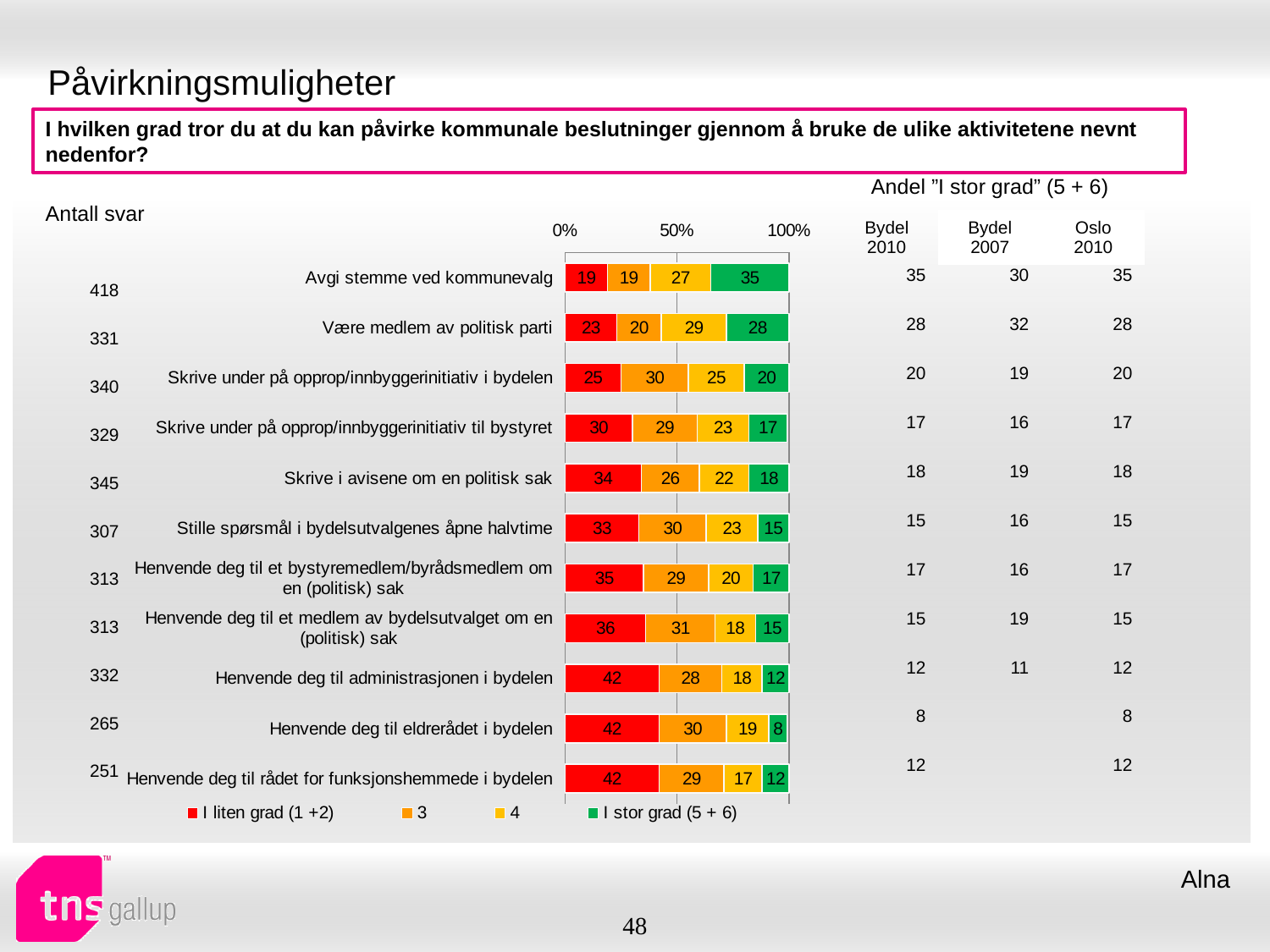
What is the value of series "3" for "Skrive i avisene om en politisk sak"? 26 What colour represents the "I stor grad (5 + 6)" series in the chart? green What is the value of "I liten grad (1 +2)" for "Henvende deg til eldrerådet i bydelen"? 42 What is the value of "I stor grad (5 + 6)" for "Avgi stemme ved kommunevalg"? 35 Which is larger: the "I stor grad (5 + 6)" value for "Være medlem av politisk parti" or for "Skrive under på opprop/innbyggerinitiativ i bydelen"? Være medlem av politisk parti What is the total of the stacked bar for "Avgi stemme ved kommunevalg"? 100 Which category has the highest "I stor grad (5 + 6)" value? Avgi stemme ved kommunevalg Which category has the lowest "I stor grad (5 + 6)" value? Henvende deg til eldrerådet i bydelen What kind of chart is shown on the slide? bar chart How many categories (activities) are plotted in the chart? 11 How many series does the chart legend list? 4 What is the difference between the "I liten grad (1 +2)" values for "Henvende deg til administrasjonen i bydelen" and "Avgi stemme ved kommunevalg"? 23